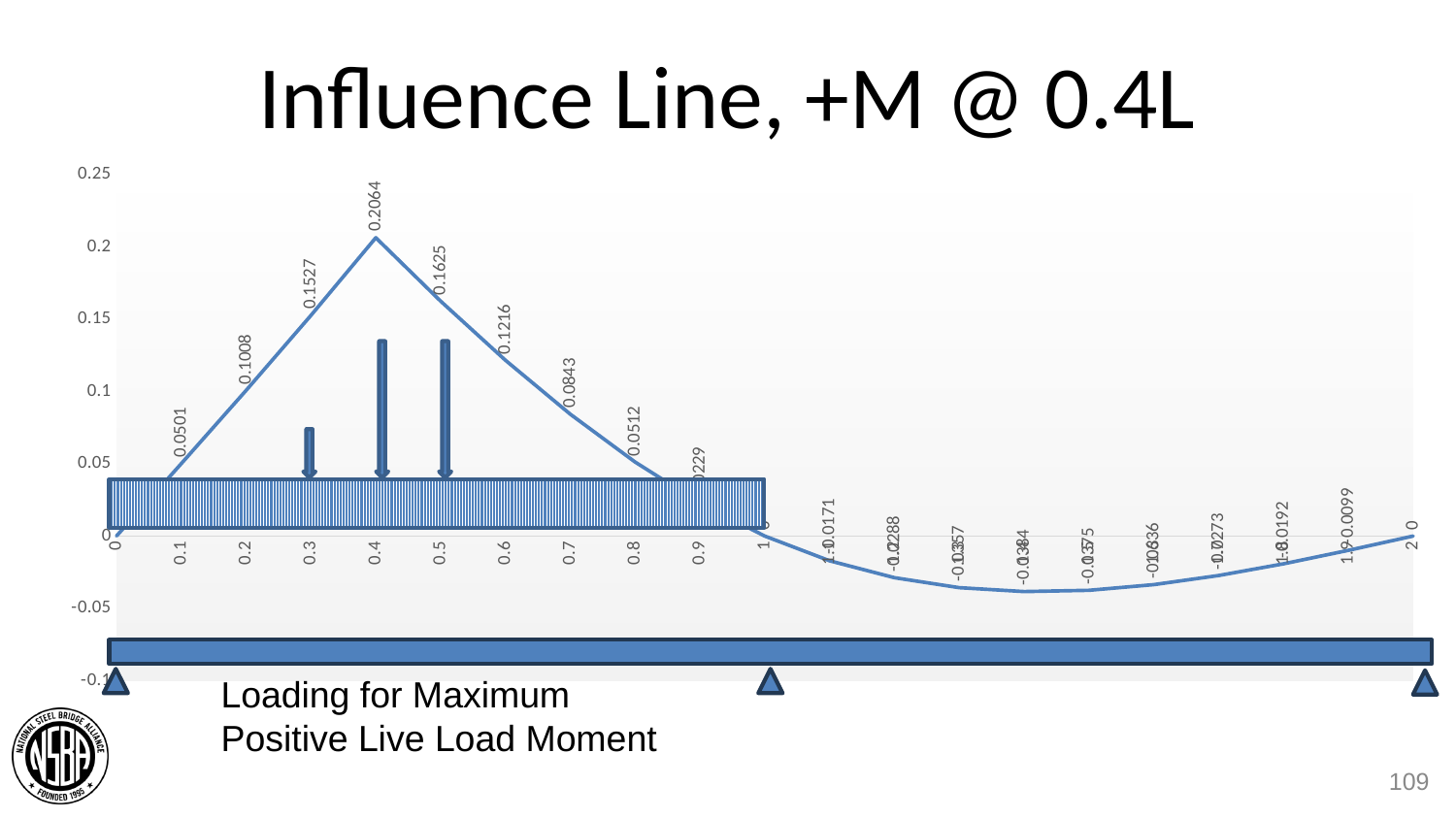
What is the influence line value at x = 0.8? 0.0512 What is the chart title? Influence Line, +M @ 0.4L Do the values rise or fall along the x axis from 0.4 to 1? fall What is the difference between the values at x = 0.3 and x = 0.2? 0.0519 Is the value at x = 1.5 greater or less than 0? less What is the difference between the values at x = 0.4 and x = 0.5? 0.0439 What is the influence line value at x = 0.4? 0.2064 Which is larger, the value at x = 0.3 or the value at x = 0.5? 0.5 What is the influence line value at x = 0.6? 0.1216 At which x position does the influence line reach its highest value? 0.4 What is the influence line value at x = 0.2? 0.1008 What kind of chart is shown on the slide? line chart